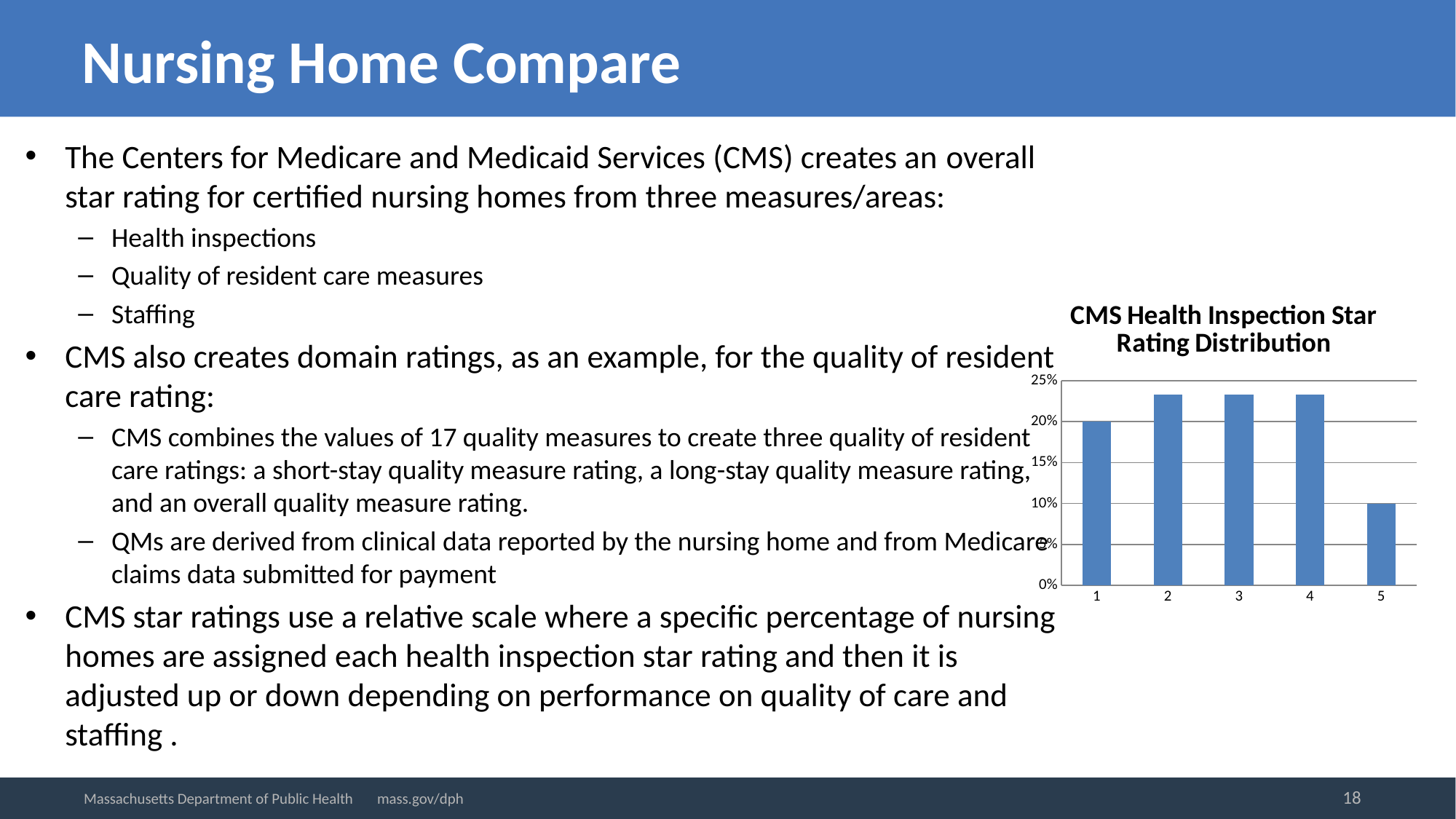
Is the value for star rating 2 greater or less than 20%? greater What is the difference between the values for star rating 1 and star rating 5? 10% Is the value for star rating 5 greater or less than 15%? less How many star rating categories are shown on the x axis of the chart? 5 What is the value for star rating 5 in the chart? 10% What kind of chart is shown on the slide? bar chart Which star rating has the lowest value in the chart? 5 What is the title of the chart on the slide? CMS Health Inspection Star Rating Distribution Is the value for star rating 4 greater or less than 25%? less Which has the larger value, star rating 1 or star rating 5? 1 Which has the larger value, star rating 3 or star rating 1? 3 What is the value for star rating 1 in the chart? 20%